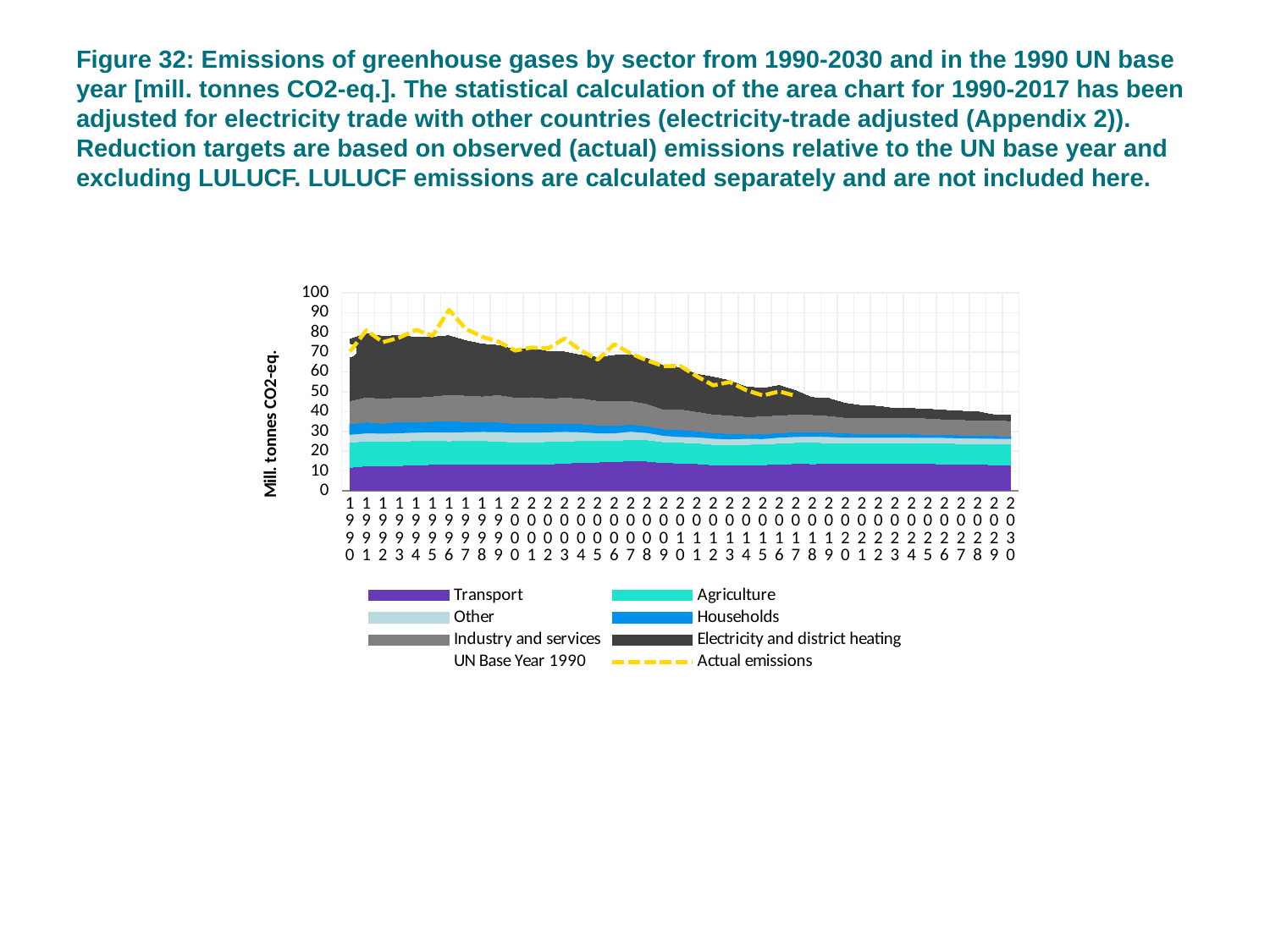
Is the total stacked emissions value in 1990 greater or less than 60? greater How many years are shown along the x axis? 41 What kind of chart is shown on the slide? area chart Which series is drawn as a yellow dashed line? Actual emissions How many series does the legend list? 8 Is the Actual emissions value in 2017 greater or less than 60? less In which year does the Actual emissions line reach its highest value? 1996 Which is larger, the total stacked emissions in 1990 or in 2030? 1990 What is the title of the y axis? Mill. tonnes CO2-eq. Do the total stacked emissions rise or fall from 1990 to 2030? fall Is the Actual emissions value in 1996 greater or less than 80? greater